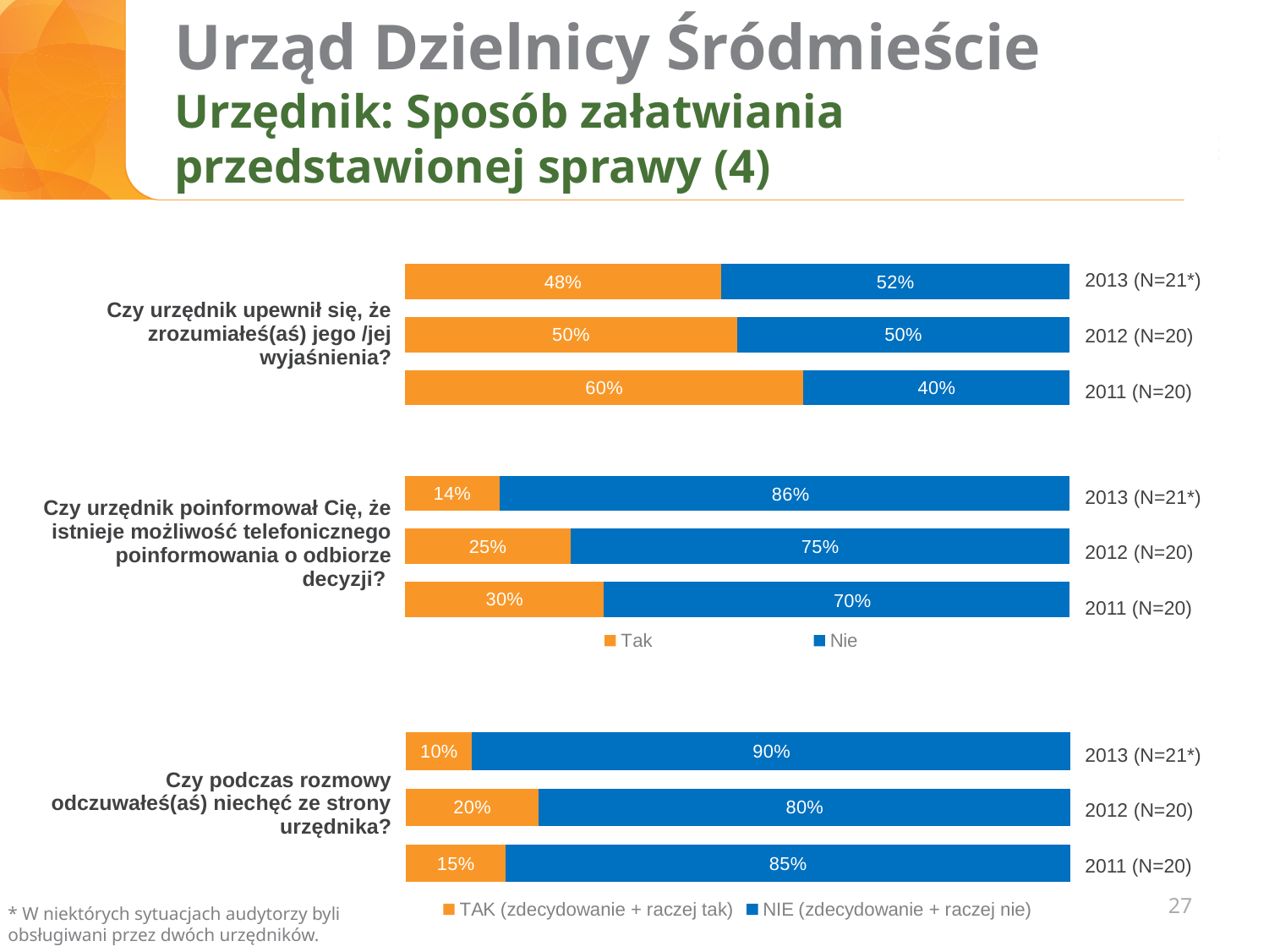
In the chart for "Czy urzędnik upewnił się, że zrozumiałeś(aś) jego /jej wyjaśnienia?", what is the difference between the Tak values for 2011 (N=20) and 2013 (N=21*)? 12 percentage points How many year categories does the chart for "Czy podczas rozmowy odczuwałeś(aś) niechęć ze strony urzędnika?" show? 3 In the chart for "Czy urzędnik poinformował Cię, że istnieje możliwość telefonicznego poinformowania o odbiorze decyzji?", which year has the highest Tak share? 2011 (N=20) In the chart for "Czy podczas rozmowy odczuwałeś(aś) niechęć ze strony urzędnika?", what is the NIE value for 2012 (N=20)? 80% In the chart for "Czy urzędnik poinformował Cię, że istnieje możliwość telefonicznego poinformowania o odbiorze decyzji?", which is larger: the Nie value for 2013 (N=21*) or for 2012 (N=20)? 2013 (N=21*) How many series does the legend below the bottom chart list? 2 In the chart for "Czy urzędnik upewnił się, że zrozumiałeś(aś) jego /jej wyjaśnienia?", what is the Nie value for 2013 (N=21*)? 52% In the chart for "Czy urzędnik upewnił się, że zrozumiałeś(aś) jego /jej wyjaśnienia?", what is the Tak value for 2011 (N=20)? 60% In the chart for "Czy urzędnik poinformował Cię, że istnieje możliwość telefonicznego poinformowania o odbiorze decyzji?", what is the total of the 2012 (N=20) bar? 100% What type of chart is used for "Czy urzędnik upewnił się, że zrozumiałeś(aś) jego /jej wyjaśnienia?"? Stacked bar chart In the chart for "Czy podczas rozmowy odczuwałeś(aś) niechęć ze strony urzędnika?", which year has the lowest TAK share? 2013 (N=21*) In the chart for "Czy urzędnik poinformował Cię, że istnieje możliwość telefonicznego poinformowania o odbiorze decyzji?", what is the Tak value for 2013 (N=21*)? 14%